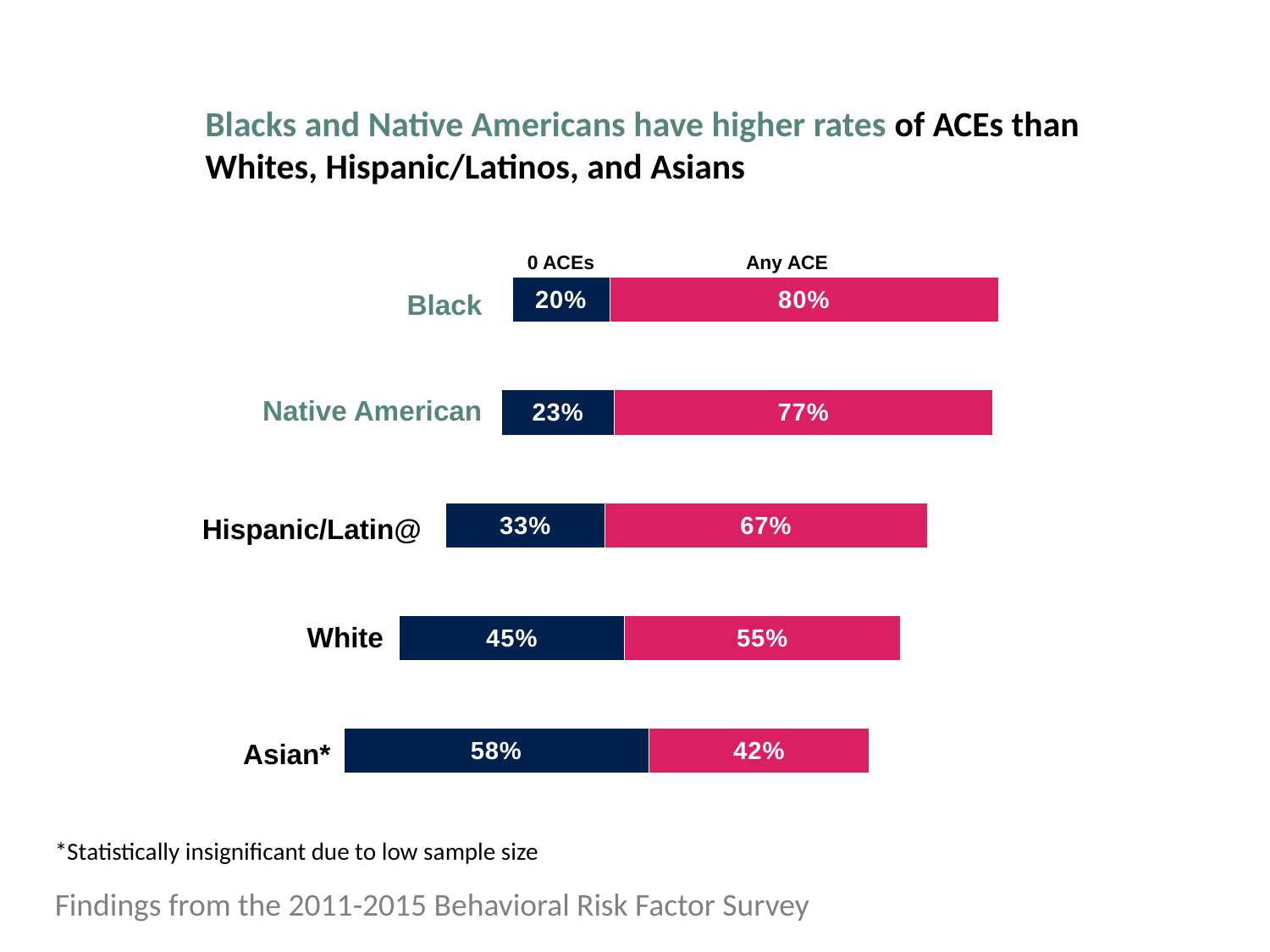
What percentage of White respondents reported 0 ACEs? 45% What is the Any ACE value for Hispanic/Latin@? 67% How many groups are shown in the chart? 5 How many series does the chart show? 2 Which group has the highest 0 ACEs percentage? Asian* What is the difference between the Any ACE percentages for Black and White? 25% Which is larger: the 0 ACEs value for Native American or for Hispanic/Latin@? Hispanic/Latin@ Which group has the lowest Any ACE percentage? Asian* What kind of chart is shown on the slide? Stacked bar chart Which group has the highest Any ACE percentage? Black What is the total of the two segments in the Native American bar? 100% What percentage of Black respondents reported any ACE? 80%